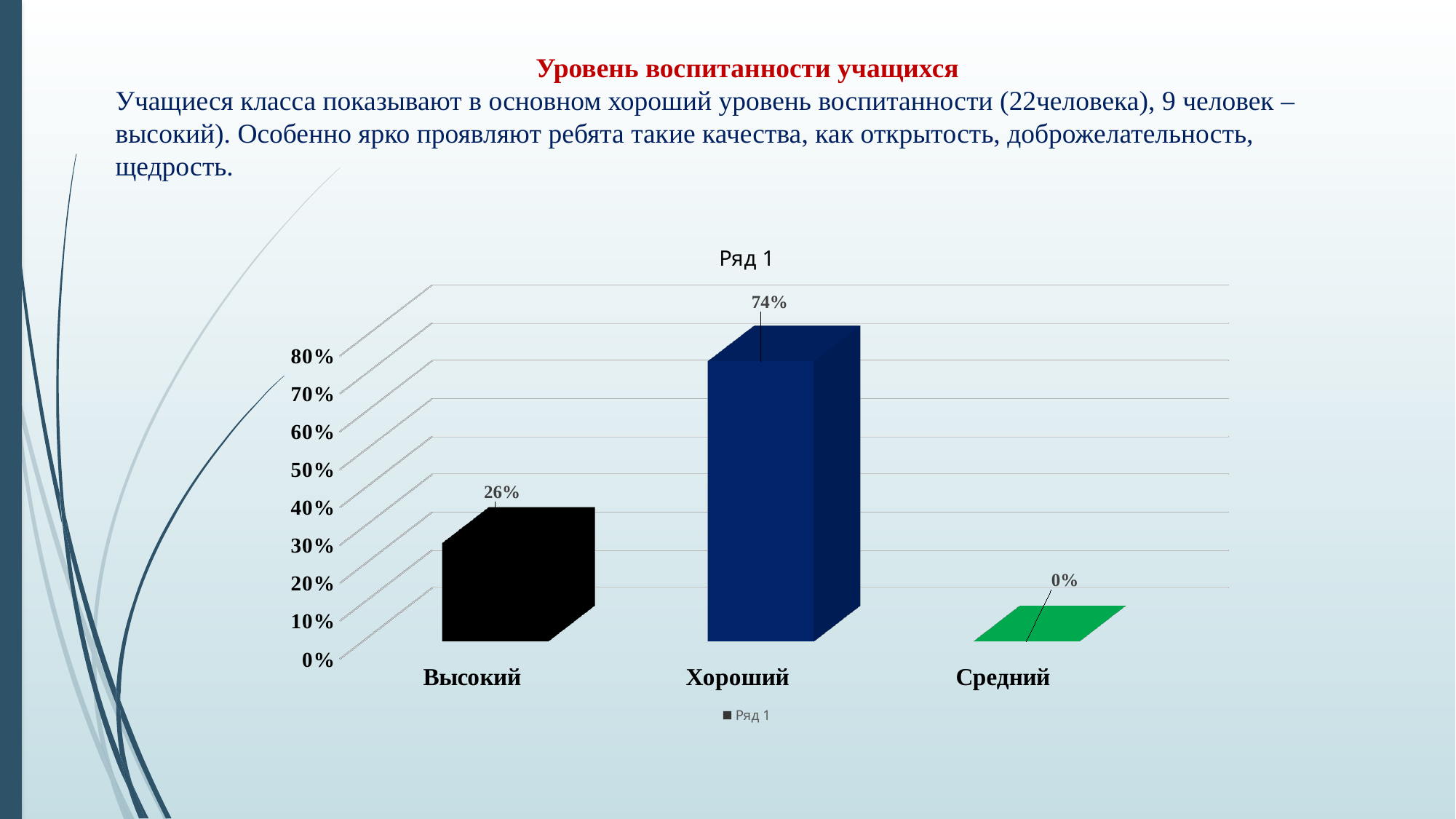
What is the value for Высокий? 26% What kind of chart is shown on the slide? bar chart What is the difference between the values for Хороший and Высокий? 48% How many categories are shown on the x axis? 3 Which category has the lowest value? Средний Which category has the highest value? Хороший What is the title of the chart? Ряд 1 How many series does the legend list? 1 What is the value for Хороший? 74% What is the value for Средний? 0% Which is larger, the value for Высокий or the value for Хороший? Хороший Is the value for Высокий greater or less than 30%? less